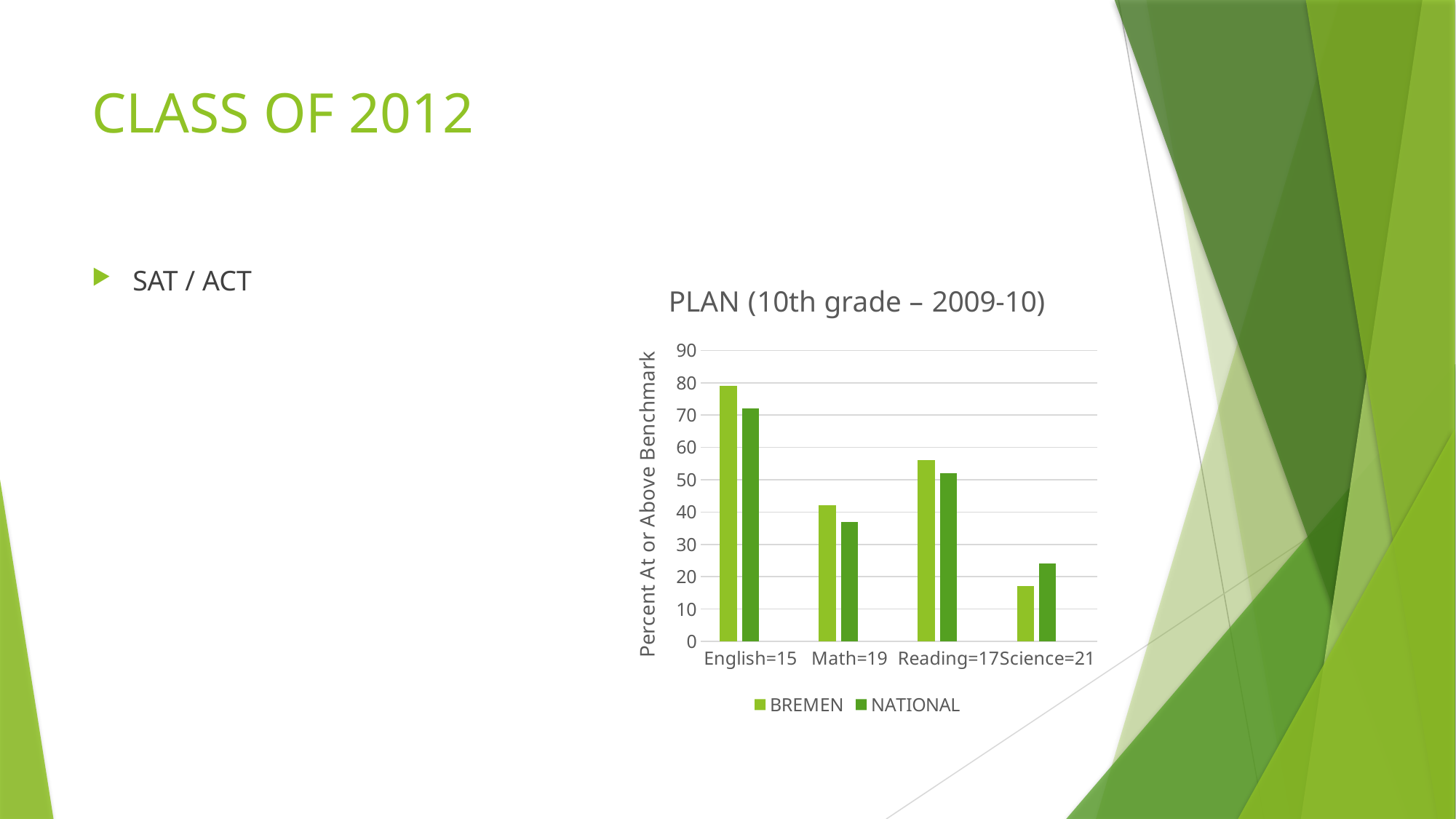
Which category has the lowest NATIONAL value? Science=21 What kind of chart is shown on the slide? bar chart What is the title of the chart? PLAN (10th grade – 2009-10) For English=15, which is larger, the BREMEN value or the NATIONAL value? BREMEN How many categories are shown on the x axis of the chart? 4 How many series does the chart's legend list? 2 For Science=21, which is larger, the BREMEN value or the NATIONAL value? NATIONAL Which category has the highest BREMEN value? English=15 Is the BREMEN value for English=15 greater or less than 70? greater Is the NATIONAL value for Math=19 greater or less than 40? less Is the BREMEN value for Science=21 greater or less than 20? less Which category has the lowest BREMEN value? Science=21